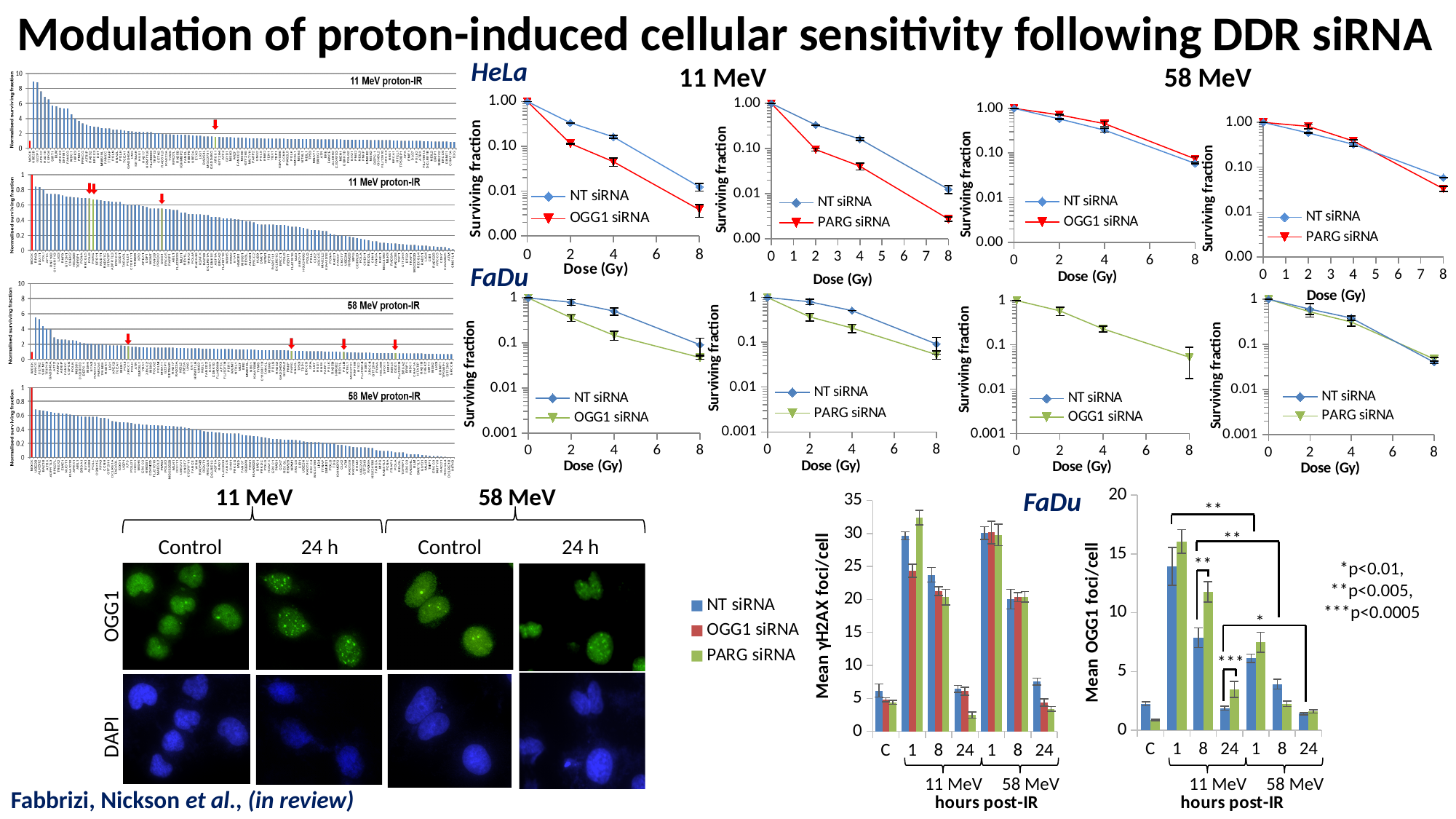
In the Mean OGG1 foci/cell chart, at 8 hours post-IR (11 MeV), which is larger: NT siRNA or PARG siRNA? PARG siRNA In the Mean OGG1 foci/cell chart, at which time point is the NT siRNA bar highest? 1 hour post-IR (11 MeV) In the HeLa 11 MeV chart comparing NT siRNA and OGG1 siRNA, does the surviving fraction rise or fall as dose increases? fall What kind of chart is the Mean γH2AX foci/cell chart? bar chart What kind of chart is the HeLa 11 MeV chart comparing NT siRNA and OGG1 siRNA? line chart In the HeLa 11 MeV chart comparing NT siRNA and OGG1 siRNA, which series has the higher surviving fraction at 4 Gy? NT siRNA In the Mean γH2AX foci/cell chart, is the NT siRNA value at 1 hour post-IR (11 MeV) greater or less than 25? greater How many series does the legend list for the Mean γH2AX foci/cell chart? 3 In the HeLa 11 MeV chart comparing NT siRNA and OGG1 siRNA, how many series does the legend list? 2 In the Mean γH2AX foci/cell chart, which series has the lowest bar at 24 hours post-IR (11 MeV)? PARG siRNA In the HeLa 11 MeV chart comparing NT siRNA and OGG1 siRNA, how many dose points are plotted for each series? 4 What is the x-axis label on the HeLa and FaDu survival line charts? Dose (Gy)